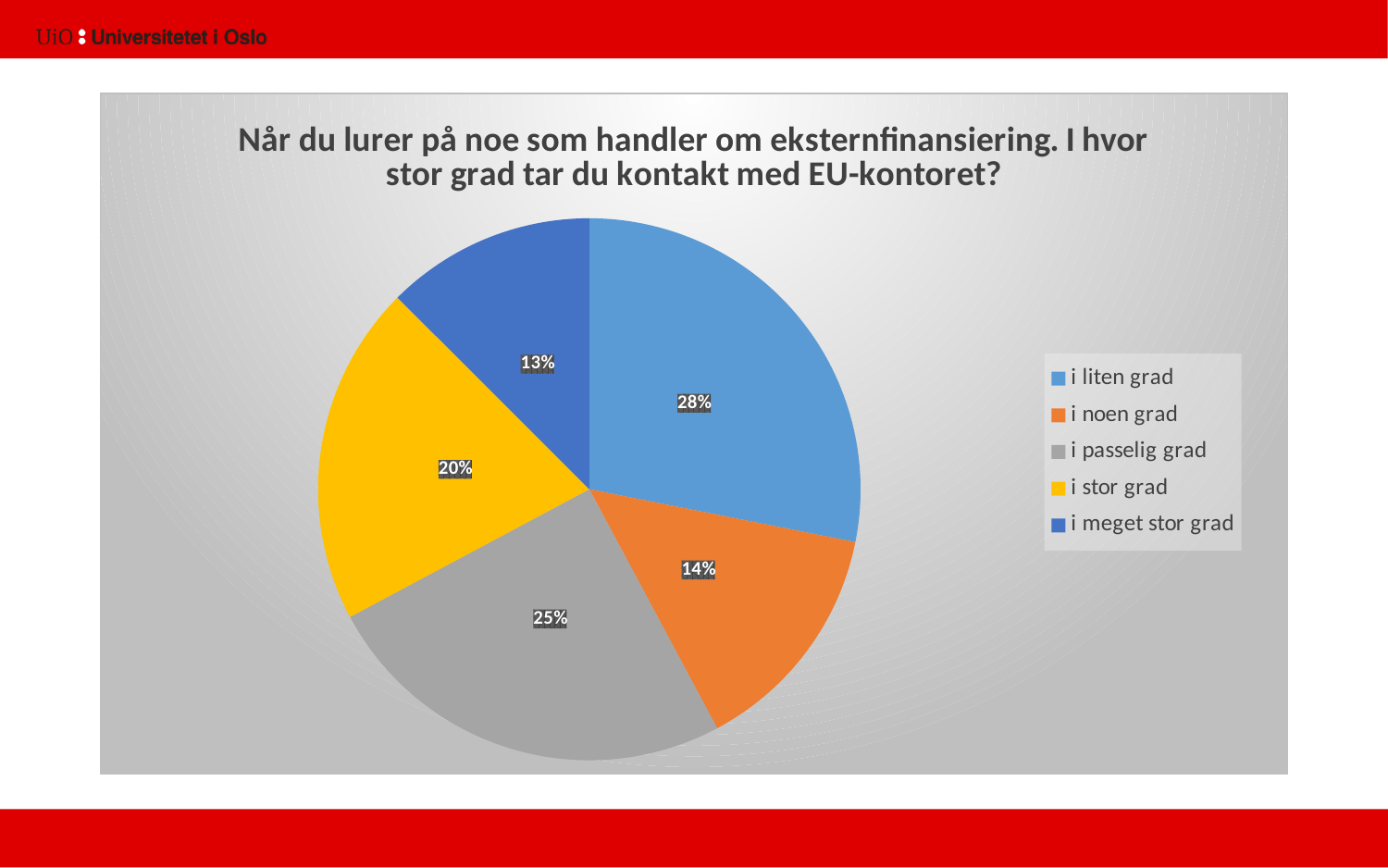
What share of the pie does "i meget stor grad" have? 13% What share of the pie does "i noen grad" have? 14% What share of the pie does "i passelig grad" have? 25% Which category has the largest slice of the pie? i liten grad Which category has the smallest slice of the pie? i meget stor grad Which is larger, the slice for "i passelig grad" or the slice for "i stor grad"? i passelig grad What kind of chart is shown on the slide? pie chart What is the difference in percentage points between "i liten grad" and "i meget stor grad"? 15 How many categories does the pie chart have? 5 What colour is the slice for "i stor grad"? yellow